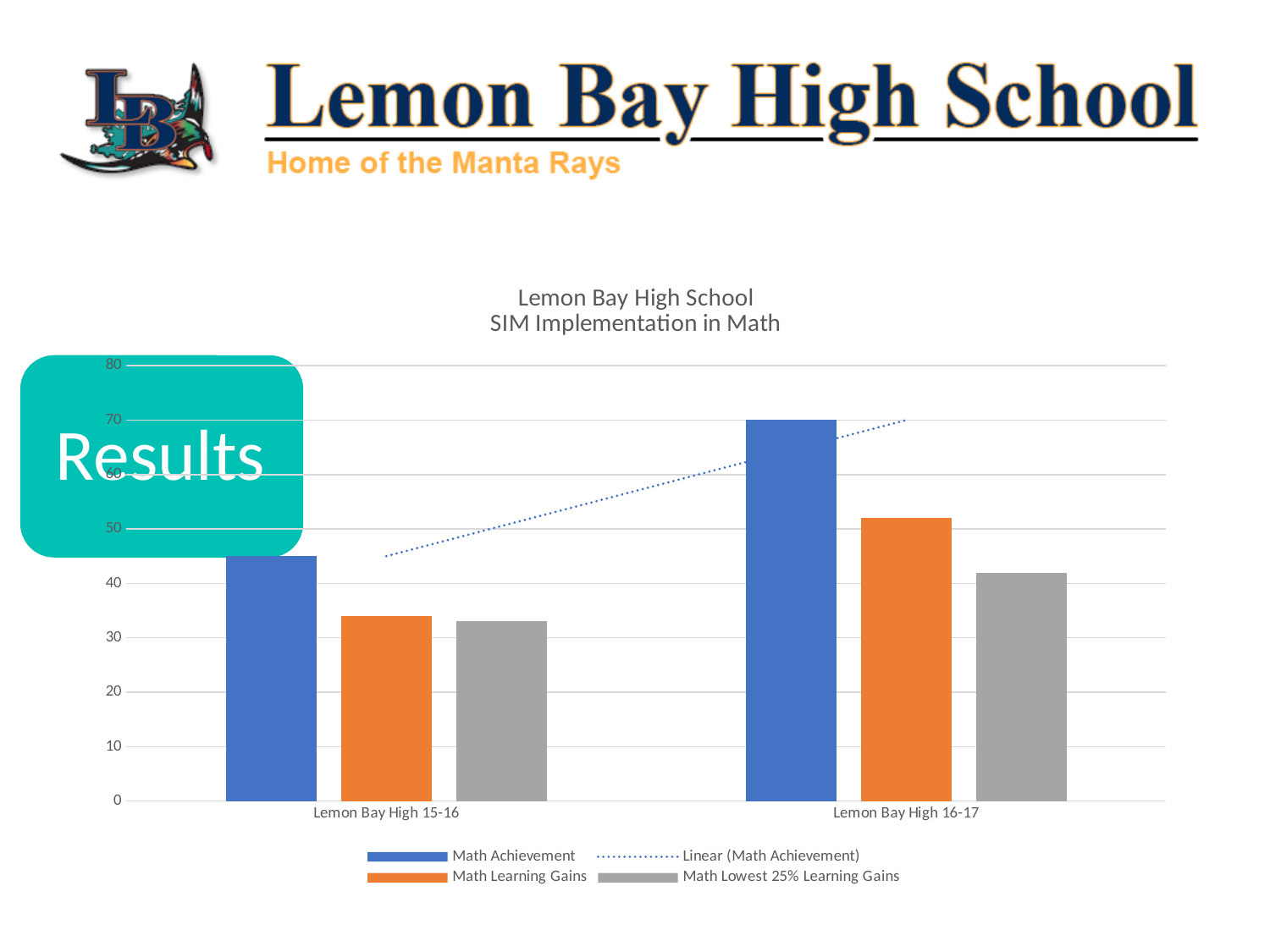
Is the Math Lowest 25% Learning Gains value for Lemon Bay High 15-16 greater or less than 40? less What is the title of the chart? Lemon Bay High School SIM Implementation in Math How many entries does the chart's legend list? 4 Does the Math Achievement value rise or fall from Lemon Bay High 15-16 to Lemon Bay High 16-17? rise Which series has the lowest value for Lemon Bay High 16-17? Math Lowest 25% Learning Gains What kind of chart is shown on the slide? bar chart Is the Math Learning Gains value for Lemon Bay High 16-17 greater or less than 40? greater Is the Math Achievement value for Lemon Bay High 15-16 greater or less than 50? less How many categories are shown on the x axis of the chart? 2 Which series has the highest value for Lemon Bay High 16-17? Math Achievement Which has the higher Math Achievement value, Lemon Bay High 15-16 or Lemon Bay High 16-17? Lemon Bay High 16-17 What is the Math Achievement value for Lemon Bay High 16-17? 70